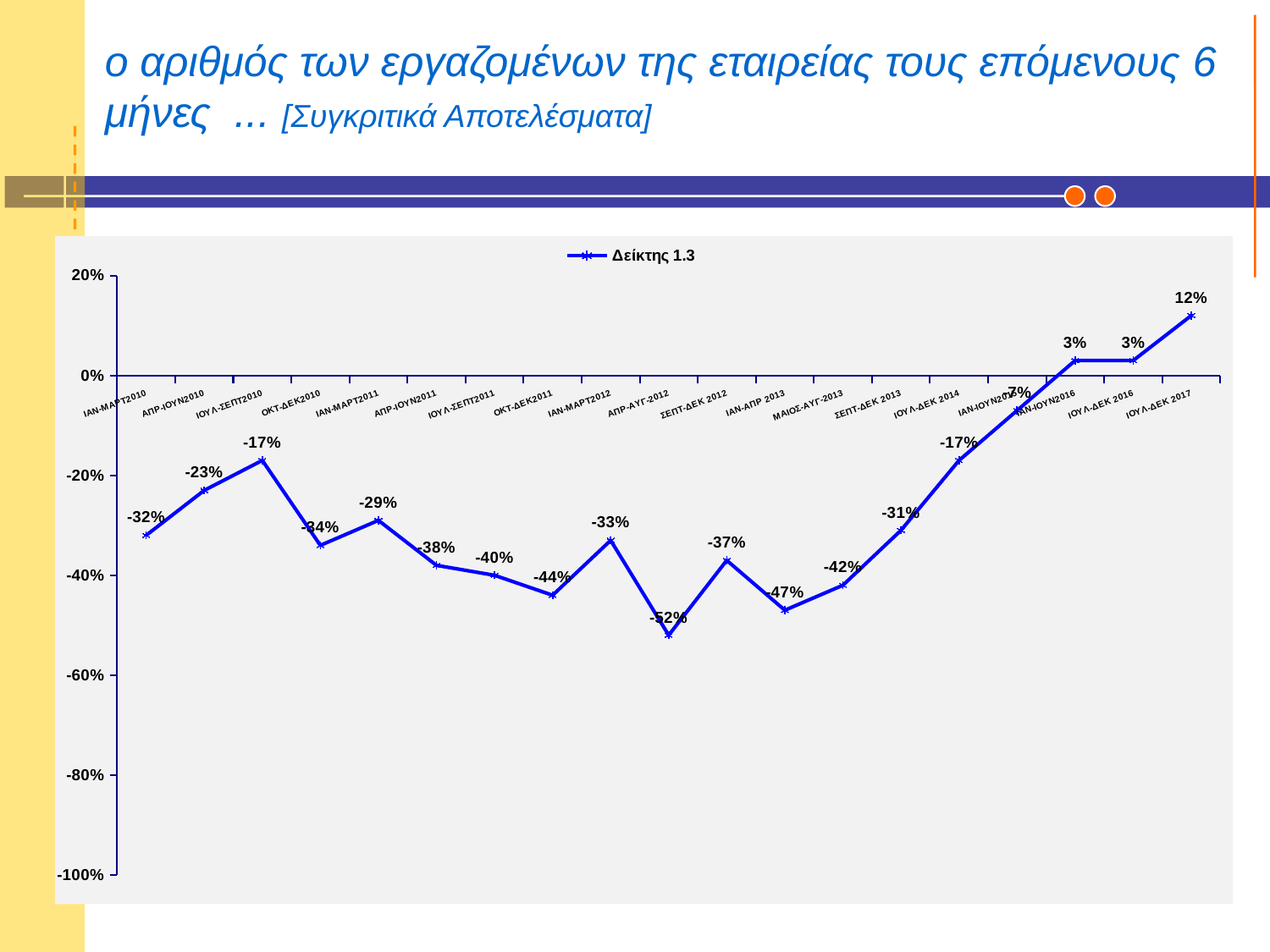
What is the value for ΙΑΝ-ΜΑΡΤ2010? -32% What is the name of the series shown in the legend? Δείκτης 1.3 How many data points are plotted on the line? 19 What is the value for ΙΟΥΛ-ΔΕΚ 2014? -17% Which is larger, the value for ΟΚΤ-ΔΕΚ2011 or the value for ΙΑΝ-ΜΑΡΤ2012? ΙΑΝ-ΜΑΡΤ2012 What is the value for ΑΠΡ-ΑΥΓ-2012? -52% Which period has the lowest value? ΑΠΡ-ΑΥΓ-2012 How many series does the legend list? 1 What is the difference between the values for ΙΟΥΛ-ΔΕΚ 2017 and ΙΑΝ-ΜΑΡΤ2010? 44 percentage points Which period has the highest value? ΙΟΥΛ-ΔΕΚ 2017 What type of chart is shown on the slide? line chart What is the value for ΙΟΥΛ-ΔΕΚ 2017? 12%